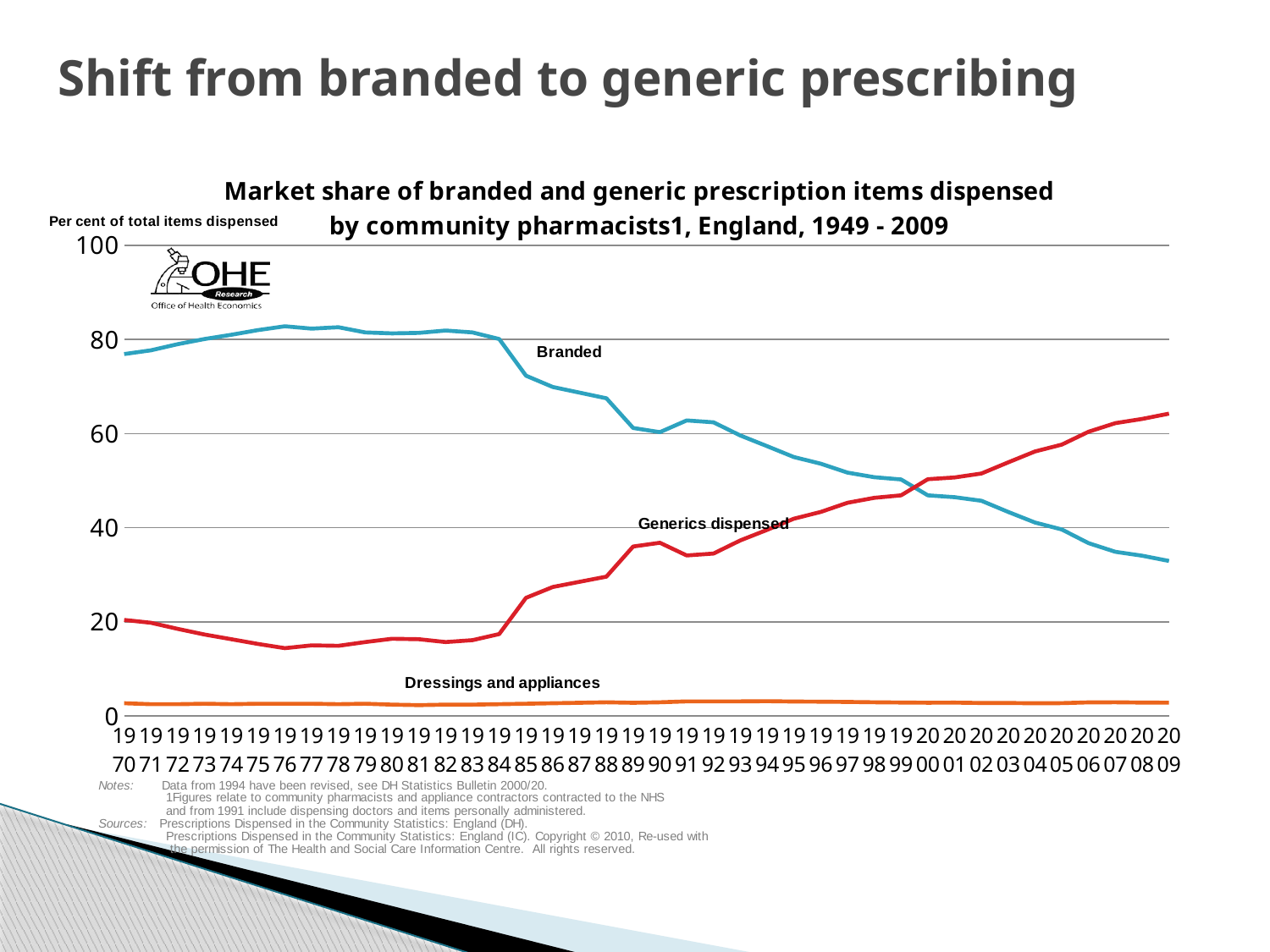
What kind of chart is shown on the slide? line chart Is the value for Dressings and appliances in 2009 greater or less than 20? less Is the value for Generics dispensed in 1970 greater or less than 40? less Is the value for Generics dispensed in 2009 greater or less than 60? greater Does the Generics dispensed series rise or fall from 1970 to 2009? rise How many series are plotted on the chart? 3 Which series has the lowest values across the whole period? Dressings and appliances Does the Branded series rise or fall from 1970 to 2009? fall In 1980, which series has the larger value, Branded or Generics dispensed? Branded In 2009, which series has the larger value, Branded or Generics dispensed? Generics dispensed